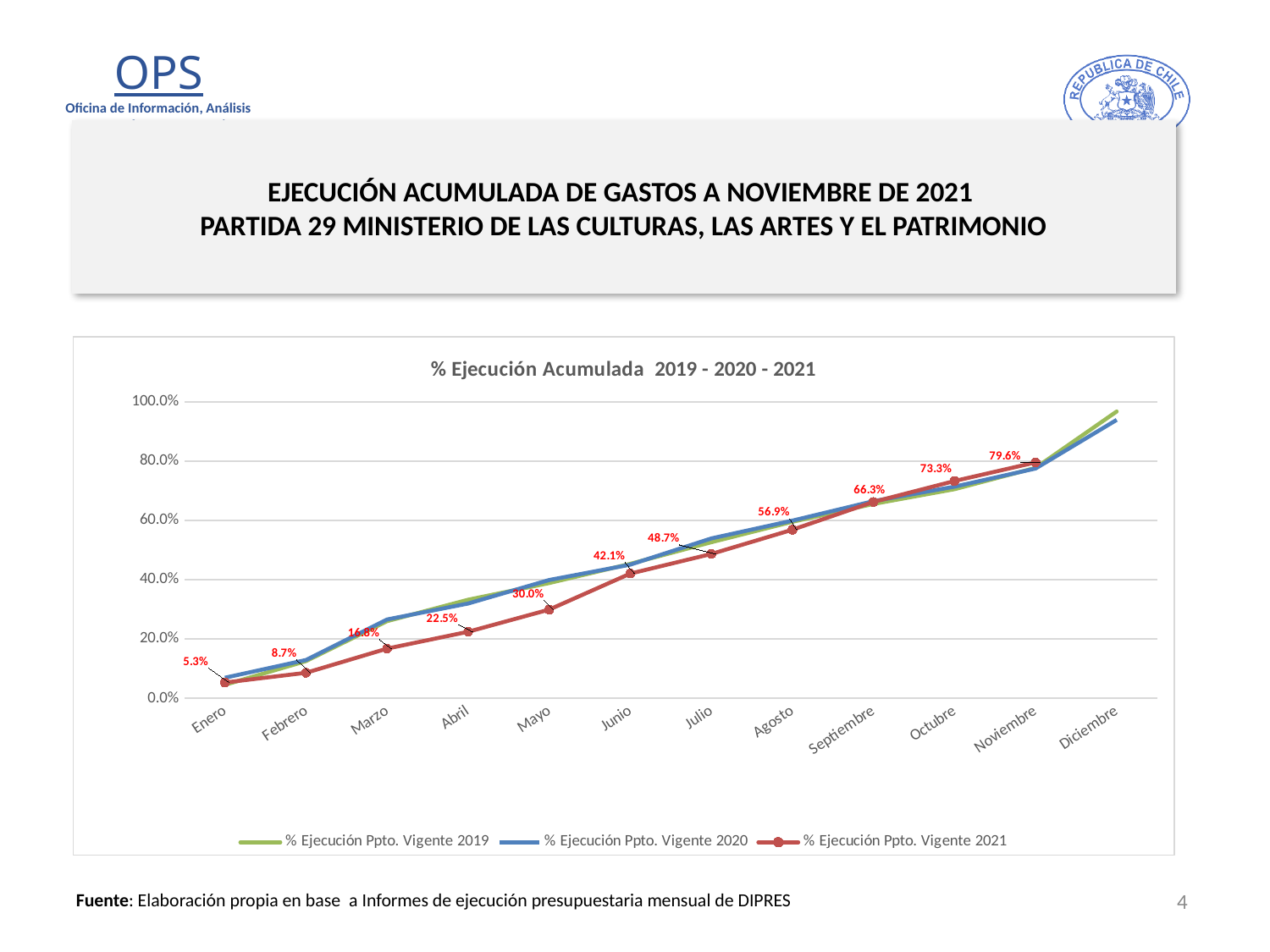
What type of chart is shown on the slide? line chart What is the value for % Ejecución Ppto. Vigente 2021 in Enero? 5.3% How many series does the legend list? 3 How many months are shown on the x axis? 12 What is the value for % Ejecución Ppto. Vigente 2021 in Noviembre? 79.6% Which month has the highest value for % Ejecución Ppto. Vigente 2021? Noviembre Which month has the lowest value for % Ejecución Ppto. Vigente 2021? Enero What is the value for % Ejecución Ppto. Vigente 2021 in Junio? 42.1% What is the chart's title? % Ejecución Acumulada 2019 - 2020 - 2021 Does the % Ejecución Ppto. Vigente 2021 series rise or fall from Enero to Noviembre? rise What is the difference between the 2021 values for Octubre and Septiembre? 7.0% Is the value for % Ejecución Ppto. Vigente 2020 in Diciembre greater or less than 80.0%? greater